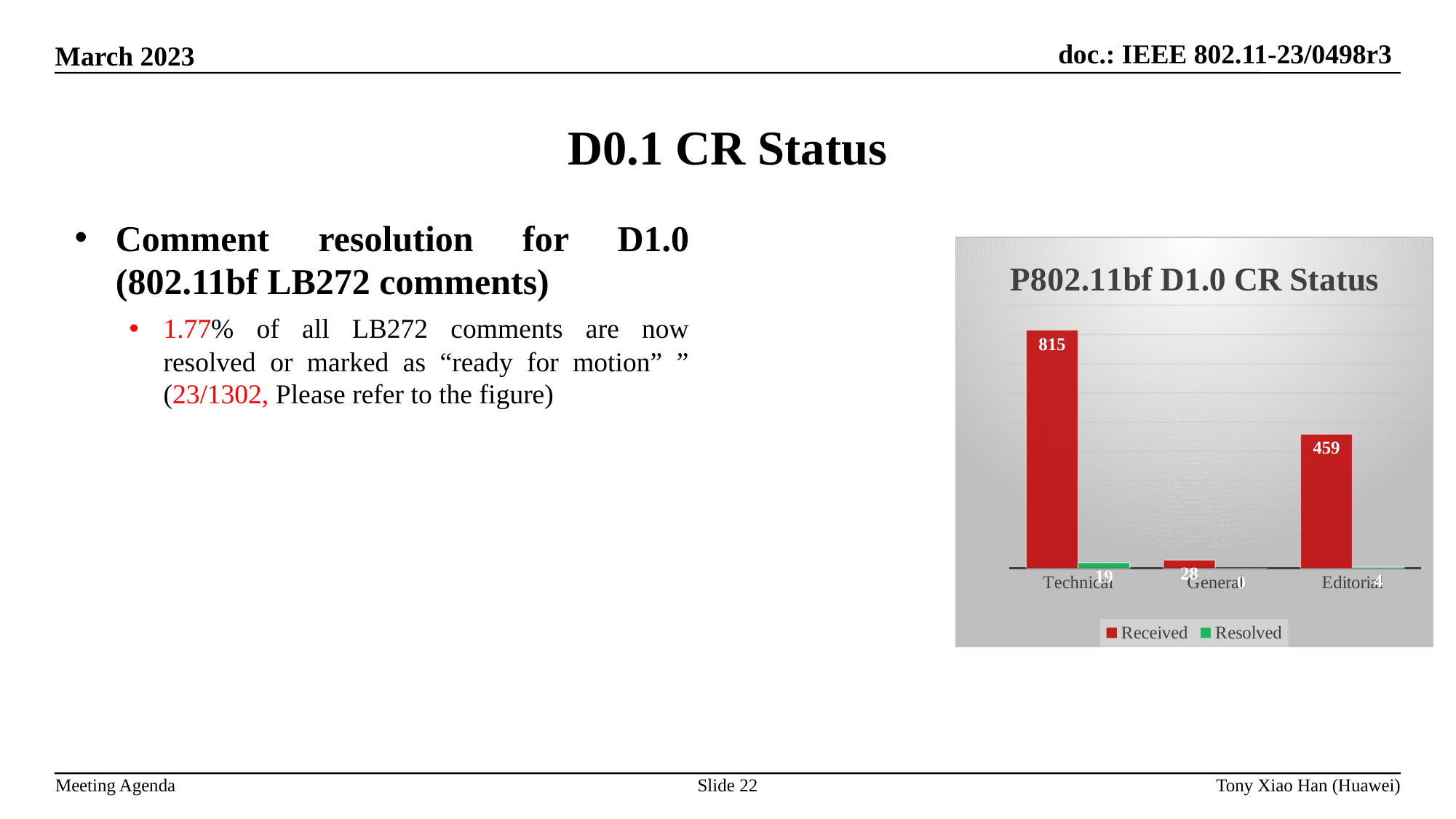
What is the Received value for Editorial? 459 Which category has the highest Received value? Technical What is the difference between the Received values for Technical and Editorial? 356 How many categories are shown on the x axis? 3 Which is larger, the Received value for General or the Received value for Editorial? Editorial What is the Resolved value for Technical? 19 What kind of chart is shown on the slide? Bar chart What is the Received value for Technical? 815 What is the Received value for General? 28 How many series does the legend list? 2 Which category has the lowest Resolved value? General What is the title of the chart? P802.11bf D1.0 CR Status